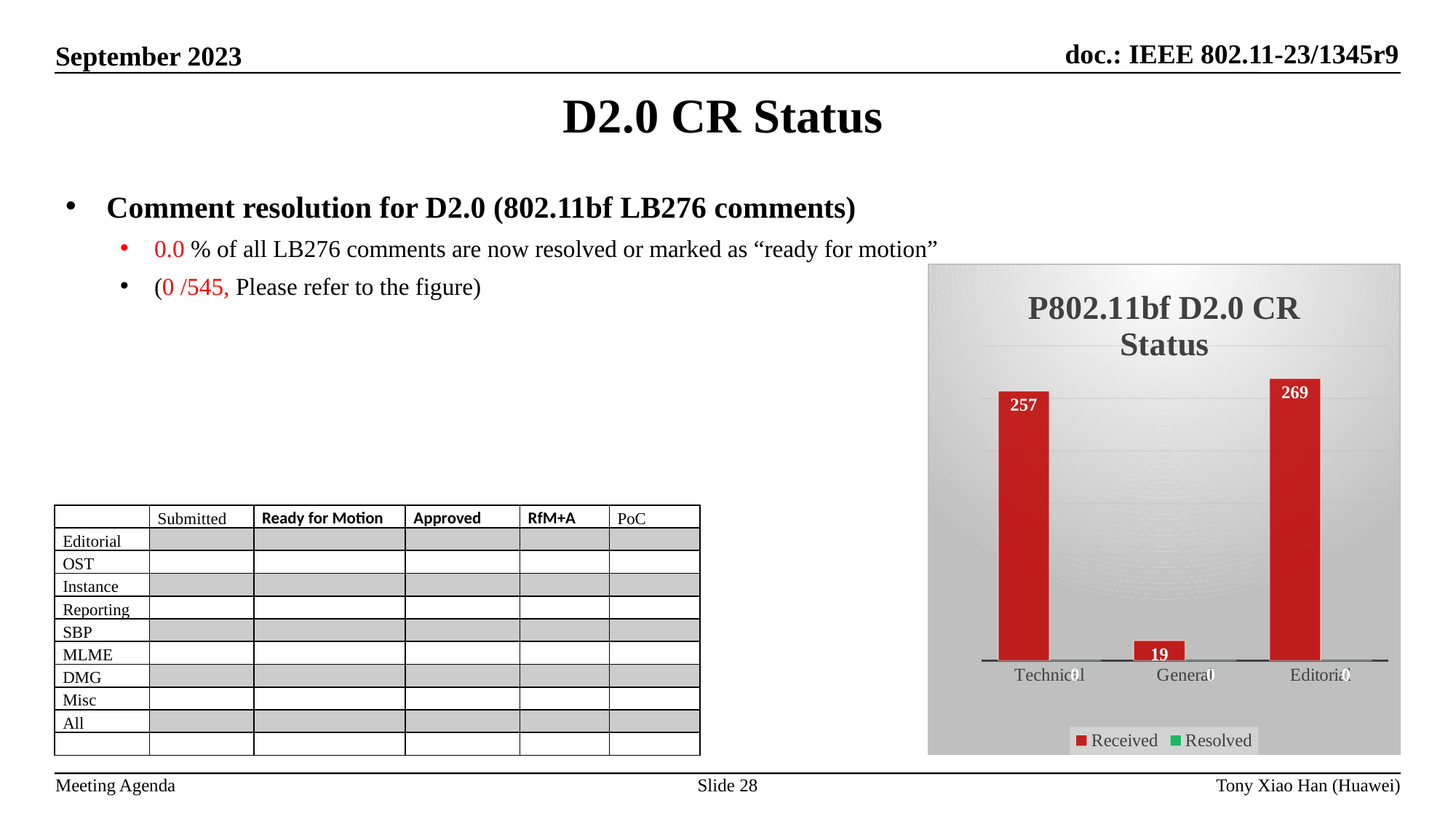
Which category has the lowest Received value? General What is the title of the chart on the slide? P802.11bf D2.0 CR Status What type of chart is shown on the slide? bar chart Which category has the highest Received value? Editorial What is the Received value for Technical? 257 How many categories are shown on the x axis of the chart? 3 Which has a larger Received value, Technical or General? Technical What is the difference between the Received values for Editorial and Technical? 12 How many series does the chart legend list? 2 What is the Received value for Editorial? 269 Which series are listed in the chart legend? Received, Resolved What is the Received value for General? 19